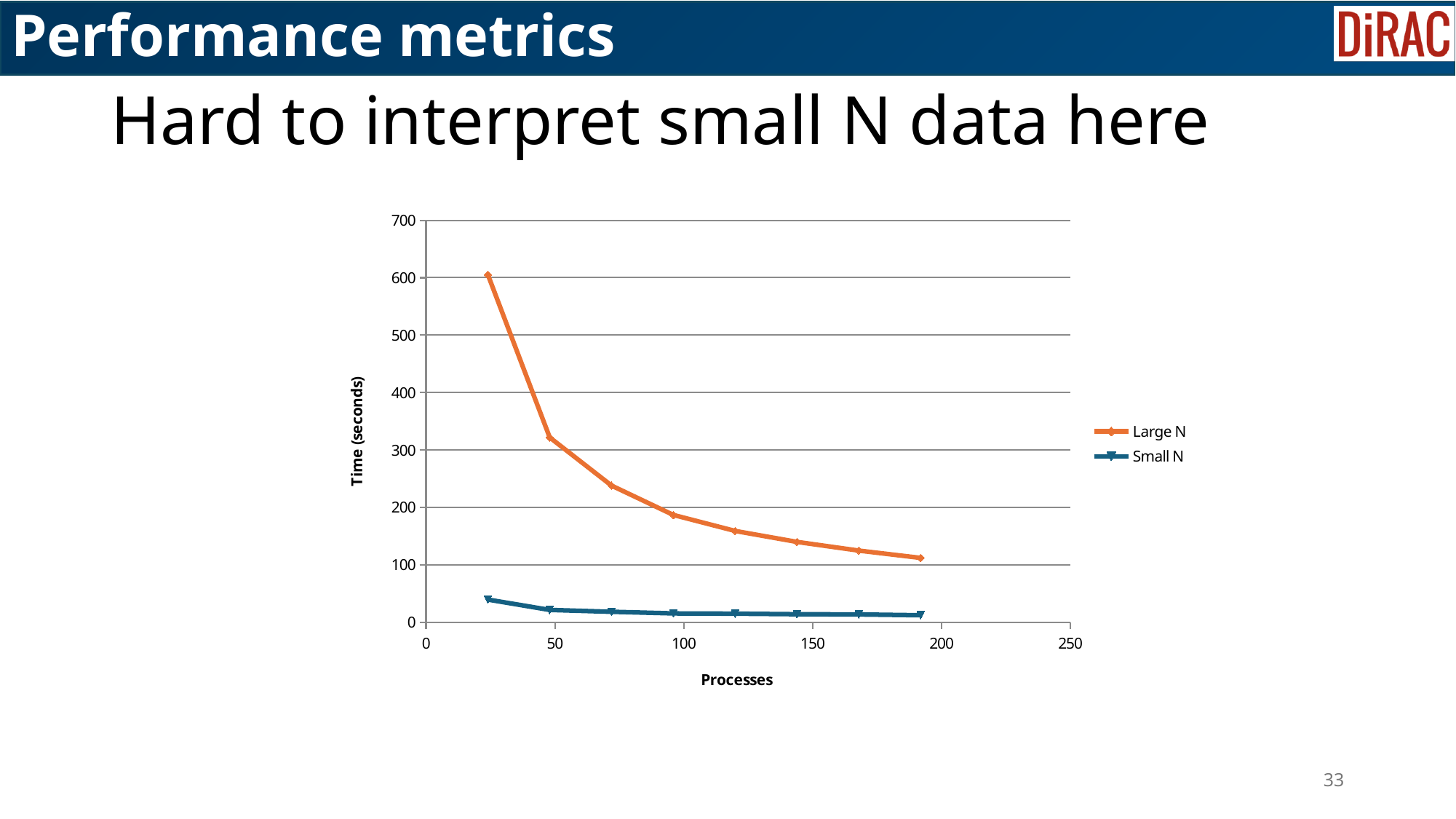
Is the Large N time at the smallest number of processes greater or less than 500 seconds? greater How many data points are plotted for the Large N series? 8 What kind of chart is shown on the slide? line chart What are the names of the two series in the legend? Large N and Small N Is the Large N time at about 192 processes greater or less than 200 seconds? less What is the label of the y axis? Time (seconds) How many series does the legend list? 2 Does the time for Large N rise or fall as the number of processes increases? fall Is the Small N time at the smallest number of processes greater or less than 100 seconds? less At about 96 processes, which series has the larger time, Large N or Small N? Large N Does the time for Small N rise or fall as the number of processes increases? fall